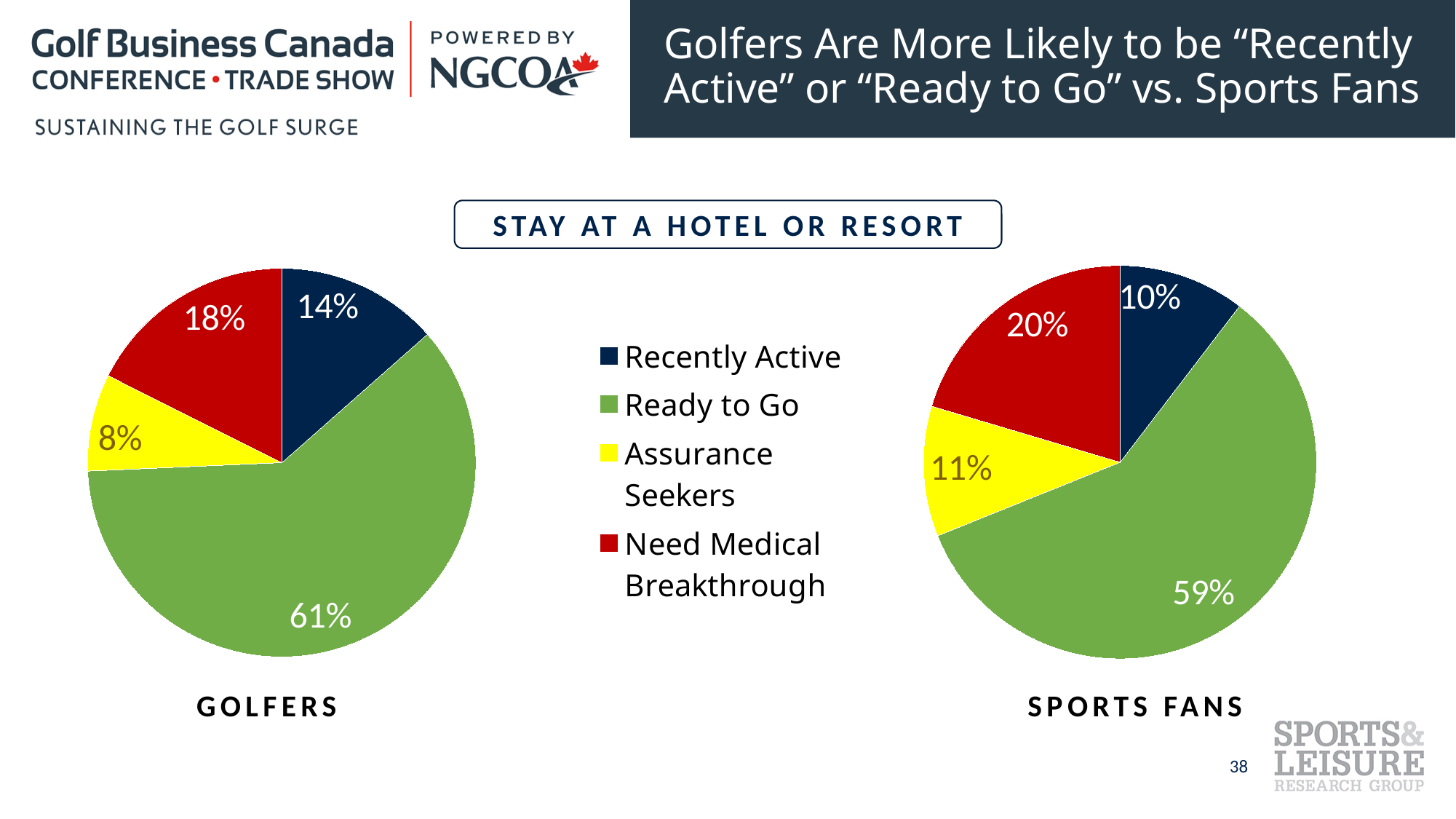
In the Golfers pie chart, which segment is the smallest? Assurance Seekers In the Sports Fans pie chart, what share is Assurance Seekers? 11% What colour represents Assurance Seekers in the legend? Yellow In the Golfers pie chart, which segment is the largest? Ready to Go What is the difference between the Recently Active share for Golfers and for Sports Fans? 4 percentage points In the Golfers pie chart, what share is Need Medical Breakthrough? 18% In the Sports Fans pie chart, what share is Recently Active? 10% Which group has a larger Need Medical Breakthrough share, Golfers or Sports Fans? Sports Fans In the Sports Fans pie chart, which segment is the smallest? Recently Active In the Golfers pie chart, what share is Ready to Go? 61% How many segments does the Golfers pie chart have? 4 What type of chart is used for the Golfers and Sports Fans data? Pie chart